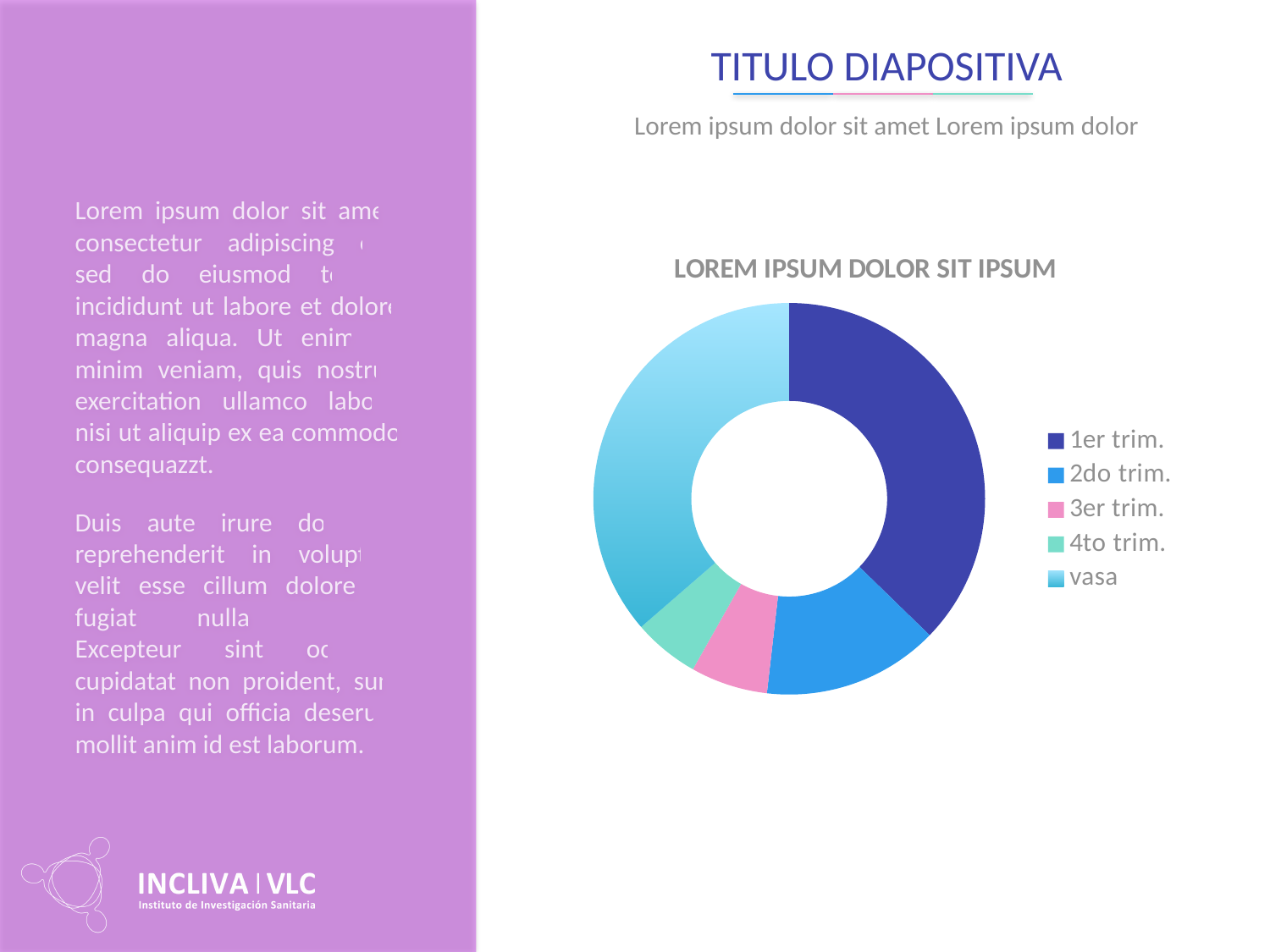
What is the last entry listed in the chart legend? vasa What is the title of the chart? LOREM IPSUM DOLOR SIT IPSUM How many entries does the chart legend list? 5 Which is larger in the chart, the slice for 2do trim. or the slice for 4to trim.? 2do trim. Which is larger in the chart, the slice for vasa or the slice for 3er trim.? vasa How many slices does the doughnut chart have? 5 What kind of chart is shown on the slide? Doughnut (pie) chart Which is larger in the chart, the slice for 1er trim. or the slice for 2do trim.? 1er trim.